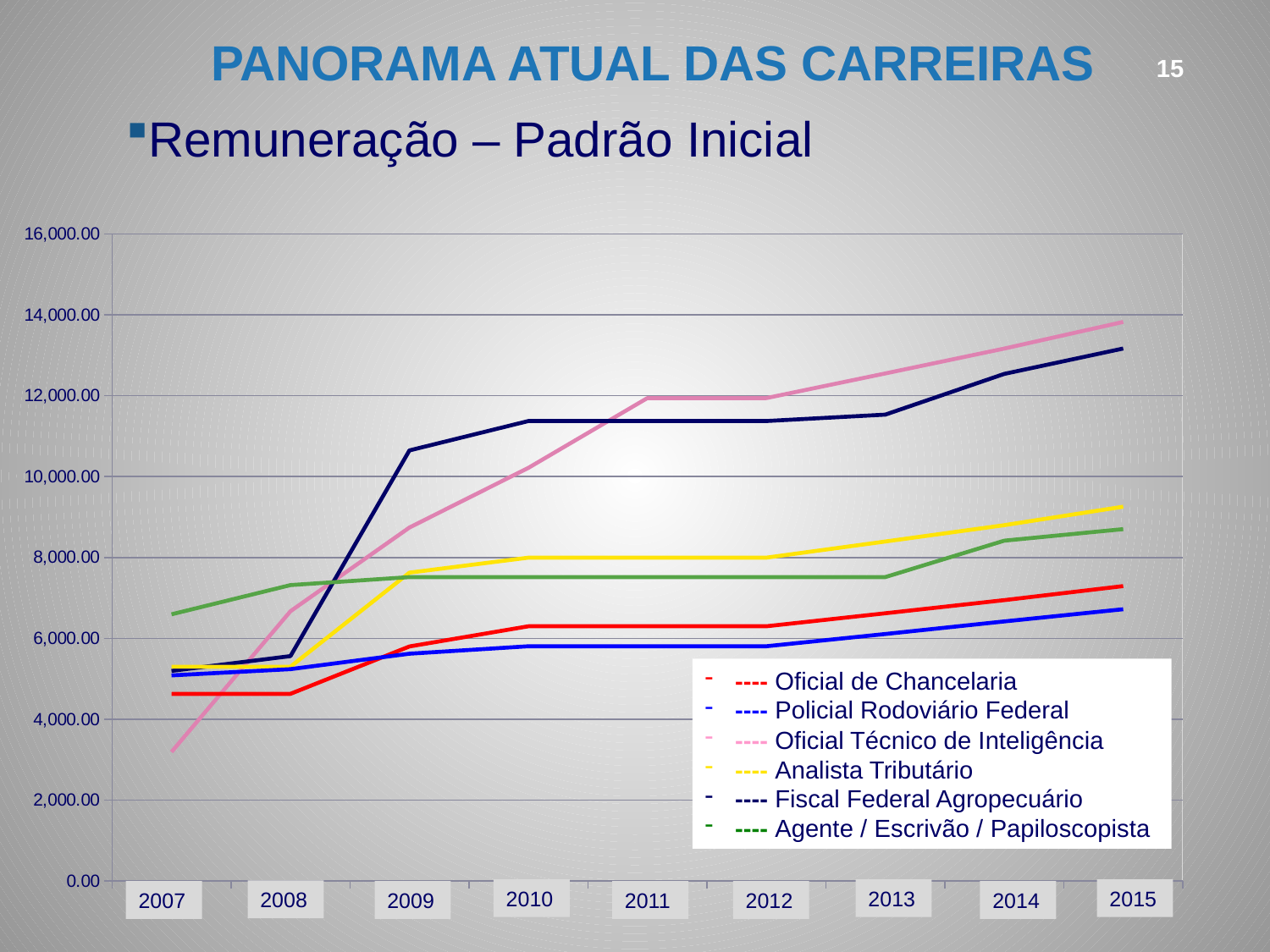
Which series has the highest value in 2015? Oficial Técnico de Inteligência Is the value for Oficial Técnico de Inteligência in 2015 greater or less than 12,000.00? greater How many years are shown along the x axis? 9 Which series has the highest value in 2007? Agente / Escrivão / Papiloscopista What kind of chart is shown on the slide? line chart Does the Oficial Técnico de Inteligência line rise or fall from 2007 to 2015? rise In 2010, which is larger: Fiscal Federal Agropecuário or Oficial Técnico de Inteligência? Fiscal Federal Agropecuário Is the value for Analista Tributário in 2015 greater or less than 8,000.00? greater Which series has the lowest value in 2007? Oficial Técnico de Inteligência Which series has the lowest value in 2015? Policial Rodoviário Federal Is the value for Oficial Técnico de Inteligência in 2007 greater or less than 4,000.00? less How many series does the legend list? 6